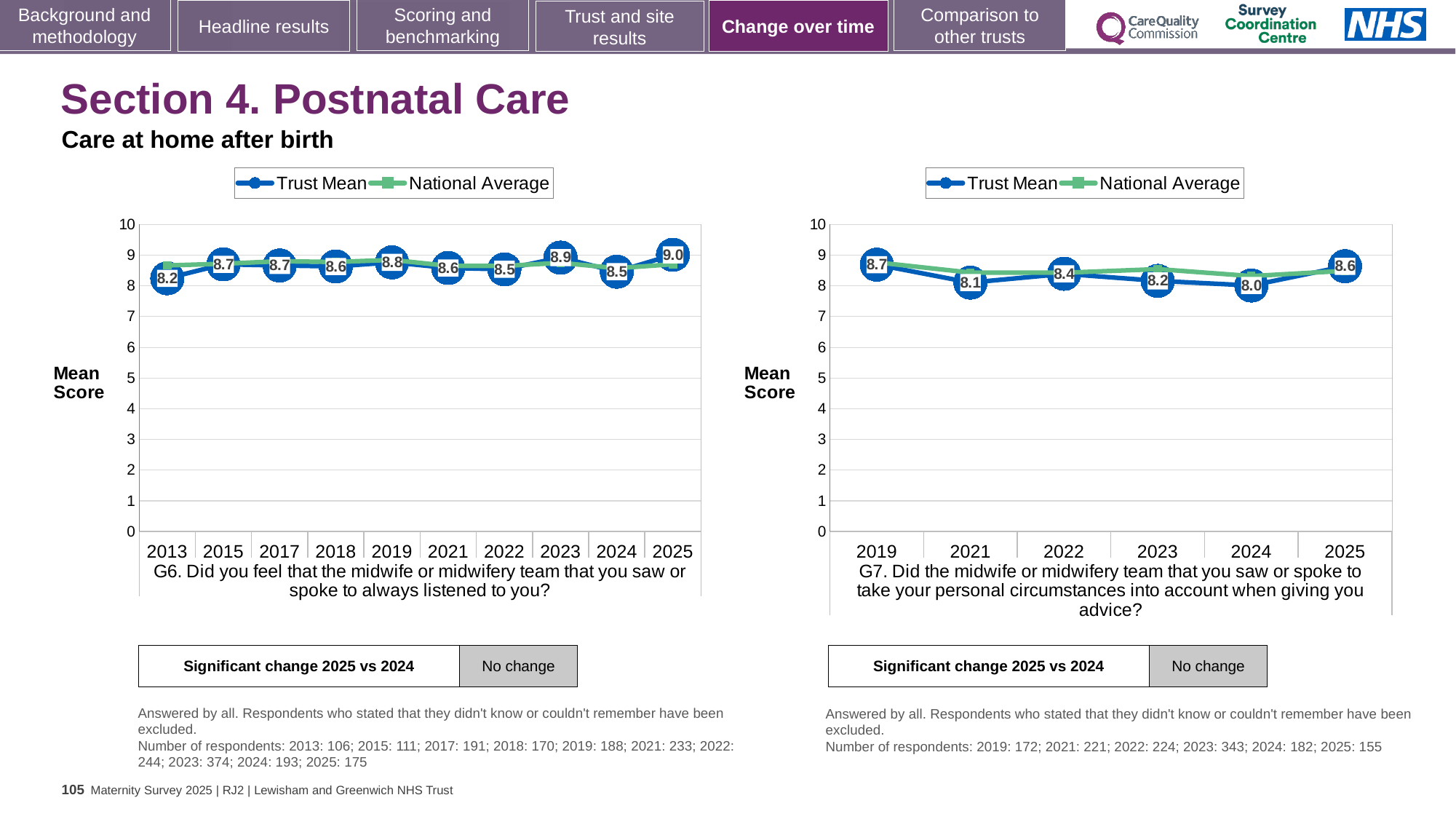
What type of chart is the G6 chart on the left? Line chart On the G6 chart (left), which year has the lowest Trust Mean score? 2013 On the G6 chart (left), what is the difference between the Trust Mean scores for 2025 and 2024? 0.5 On the G6 chart (left), what is the Trust Mean score for 2025? 9.0 On the G6 chart (left), which year has the highest Trust Mean score? 2025 On the G7 chart (right), what is the Trust Mean score for 2024? 8.0 On the G6 chart (left), what is the Trust Mean score for 2013? 8.2 On the G7 chart (right), which year has the highest Trust Mean score? 2019 On the G7 chart (right), which year has the lowest Trust Mean score? 2024 On the G7 chart (right), is the Trust Mean score for 2022 or 2023 larger? 2022 On the G7 chart (right), how many series does the legend list? 2 On the G6 chart (left), how many years are plotted on the x axis? 10